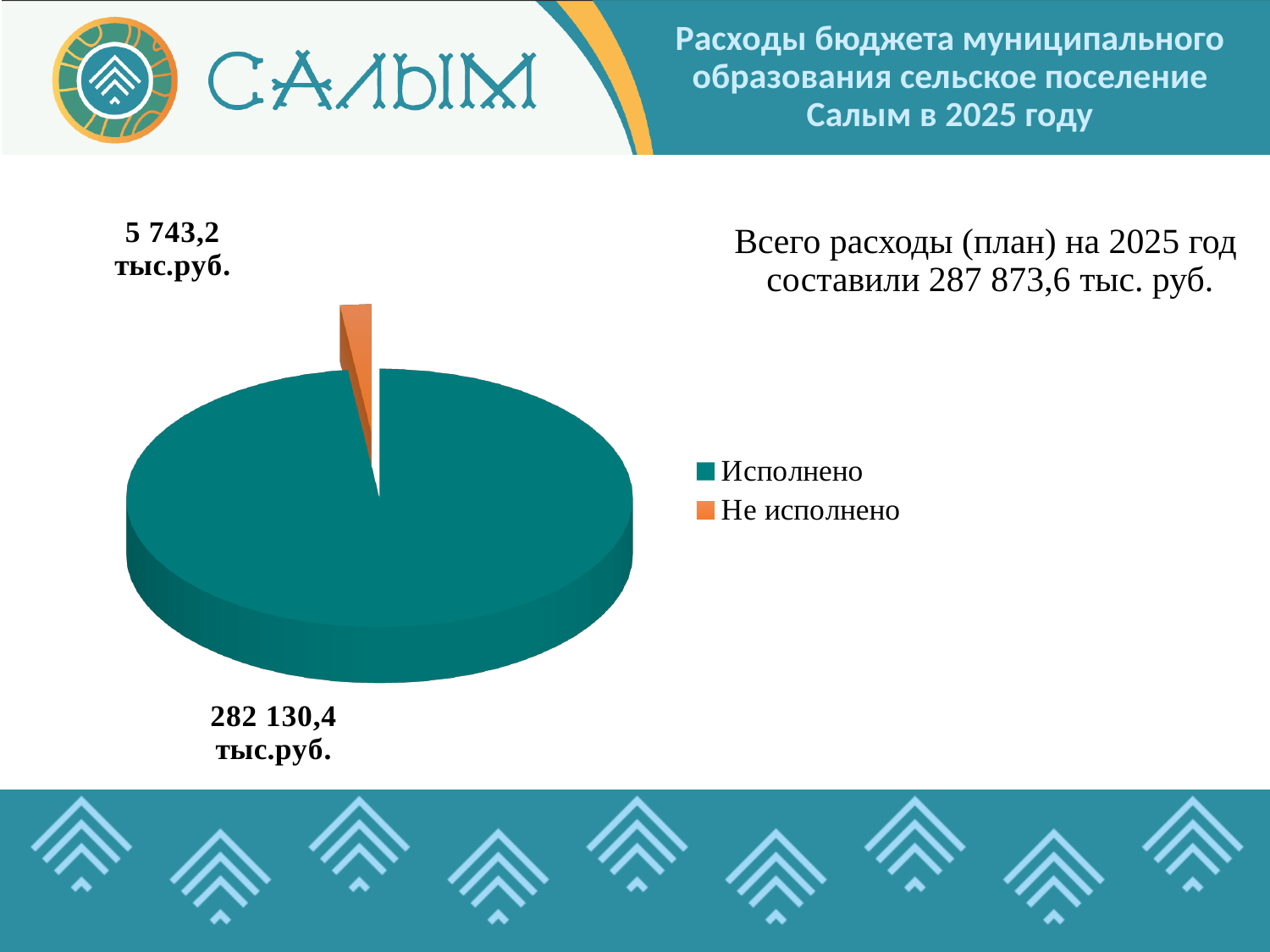
How many slices does the pie chart have? 2 Which slice of the pie chart is the largest? Исполнено How many entries does the legend list? 2 What is the total of the two slices in the pie chart? 287 873,6 тыс.руб. What is the value of the "Не исполнено" slice? 5 743,2 тыс.руб. What kind of chart is shown on the slide? Pie chart What is the value of the "Исполнено" slice? 282 130,4 тыс.руб. What colour is the "Не исполнено" slice? Orange Which is larger, "Исполнено" or "Не исполнено"? Исполнено What is the difference between the "Исполнено" and "Не исполнено" values? 276 387,2 тыс.руб. Which slice of the pie chart is the smallest? Не исполнено